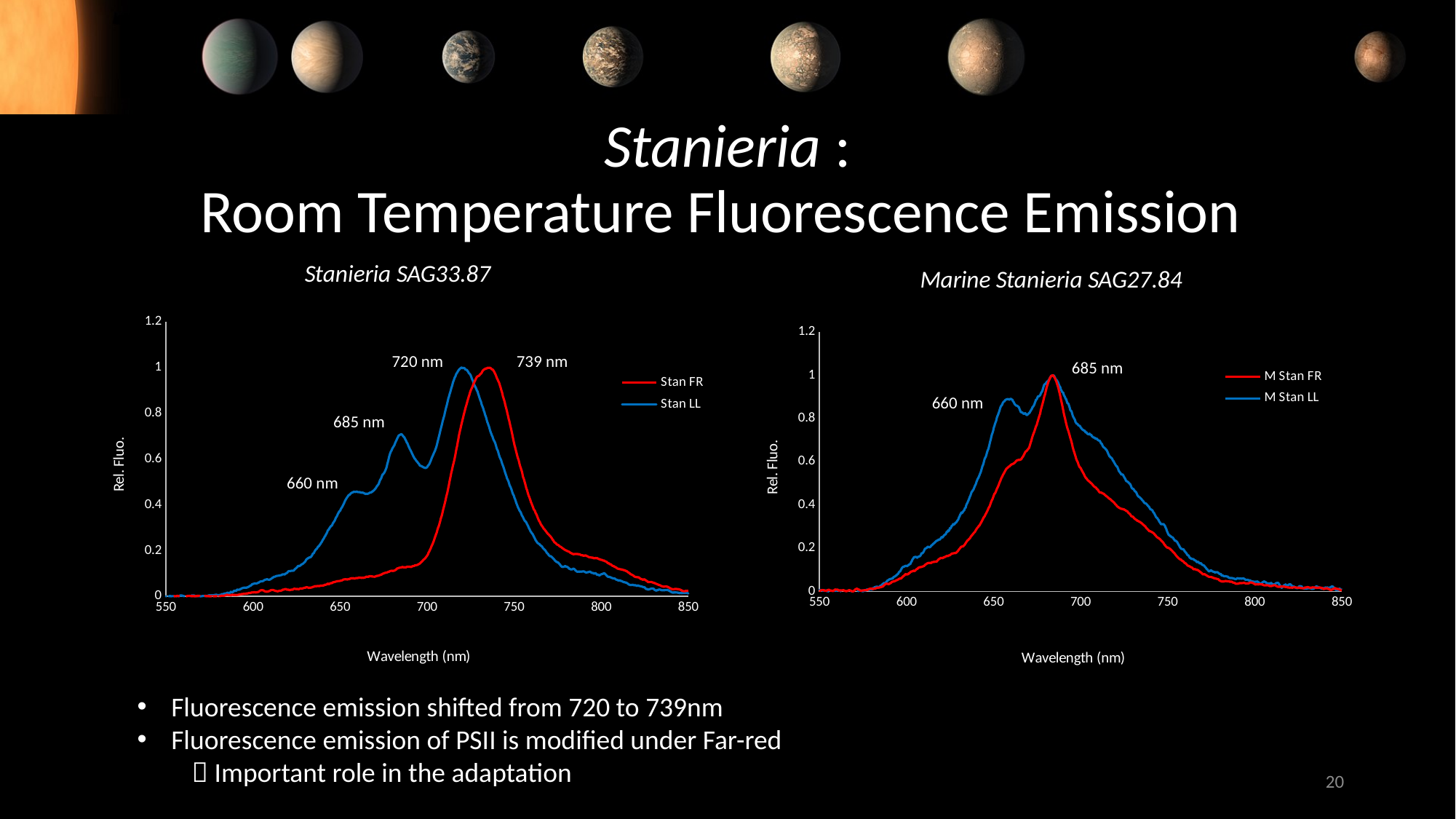
What kind of chart is the Stanieria SAG33.87 chart on the left? line chart What are the two series named in the legend of the Marine Stanieria SAG27.84 chart? M Stan FR and M Stan LL In the Stanieria SAG33.87 chart, at what wavelength is the peak of the Stan FR curve annotated? 739 nm In the Stanieria SAG33.87 chart, is the Stan FR value at 660 nm greater or less than 0.2? less How many series does the legend of the Stanieria SAG33.87 chart list? 2 In the Marine Stanieria SAG27.84 chart, at what wavelength is the main peak annotated? 685 nm In the Marine Stanieria SAG27.84 chart, is the M Stan LL value at 660 nm greater or less than 0.8? greater In the Stanieria SAG33.87 chart, is the Stan LL value at 685 nm greater or less than 0.6? greater What is the label of the x axis on the Marine Stanieria SAG27.84 chart? Wavelength (nm) In the Stanieria SAG33.87 chart, which series has the larger value at 685 nm, Stan FR or Stan LL? Stan LL In the Stanieria SAG33.87 chart, at what wavelength is the peak of the Stan LL curve annotated? 720 nm In the Marine Stanieria SAG27.84 chart, which series has the larger value at 660 nm, M Stan FR or M Stan LL? M Stan LL